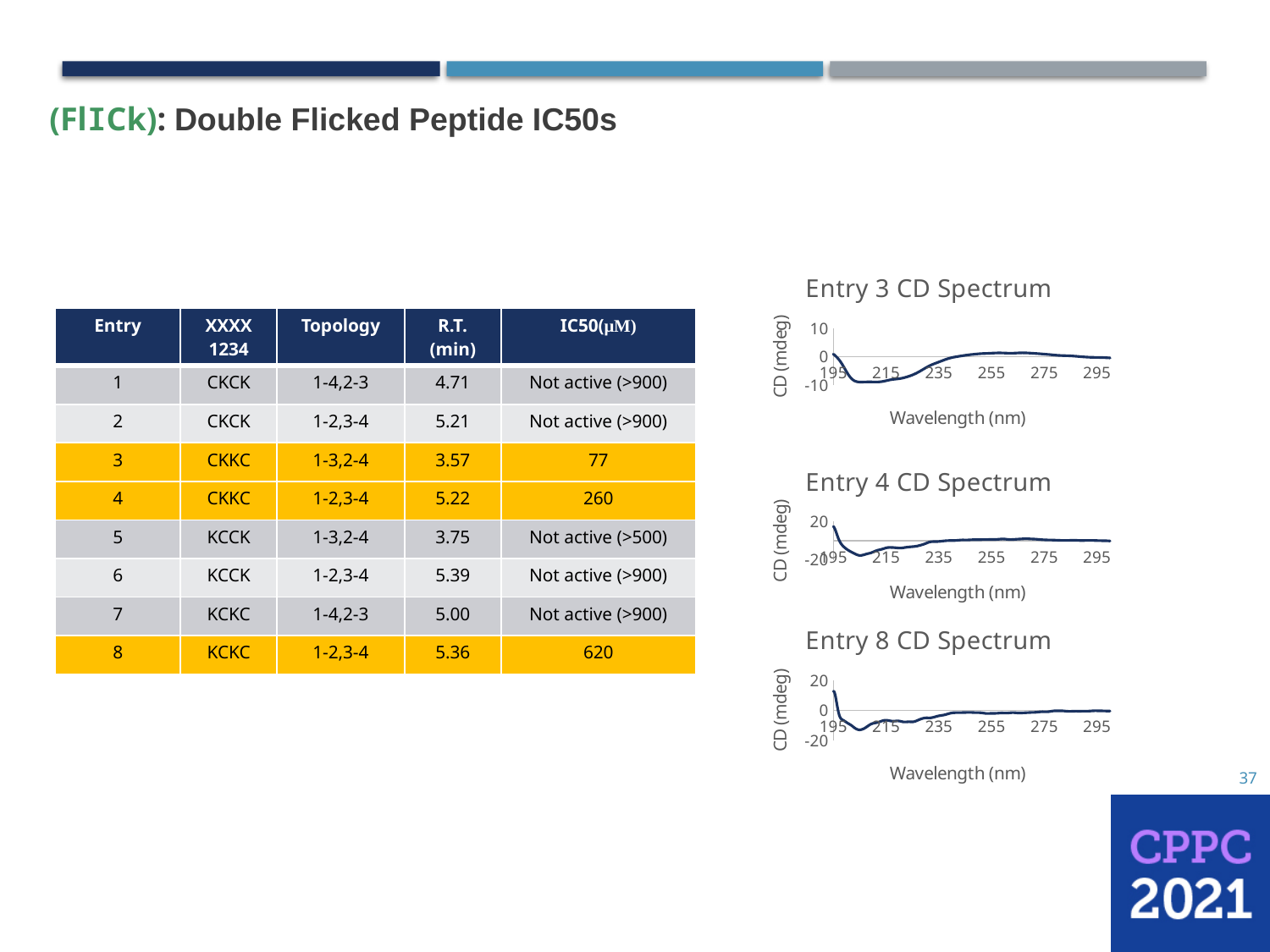
In the Entry 8 CD Spectrum chart, is the value at 215 nm greater or less than 0? less In the Entry 3 CD Spectrum chart, does the CD signal rise or fall between 195 nm and 215 nm? fall What kind of chart is the Entry 3 CD Spectrum? line chart What is the x-axis title of the Entry 8 CD Spectrum chart? Wavelength (nm) In the Entry 3 CD Spectrum chart, is the value at 215 nm greater or less than 0? less How many CD spectrum charts are shown on the slide? 3 In the Entry 4 CD Spectrum chart, is the value at 195 nm greater or less than 0? greater What is the highest y-axis tick value shown on the Entry 3 CD Spectrum chart? 10 What is the y-axis title of the Entry 3 CD Spectrum chart? CD (mdeg) How many wavelength tick labels are shown on the x axis of the Entry 4 CD Spectrum chart? 6 In the Entry 4 CD Spectrum chart, does the CD signal rise or fall between 195 nm and 205 nm? fall